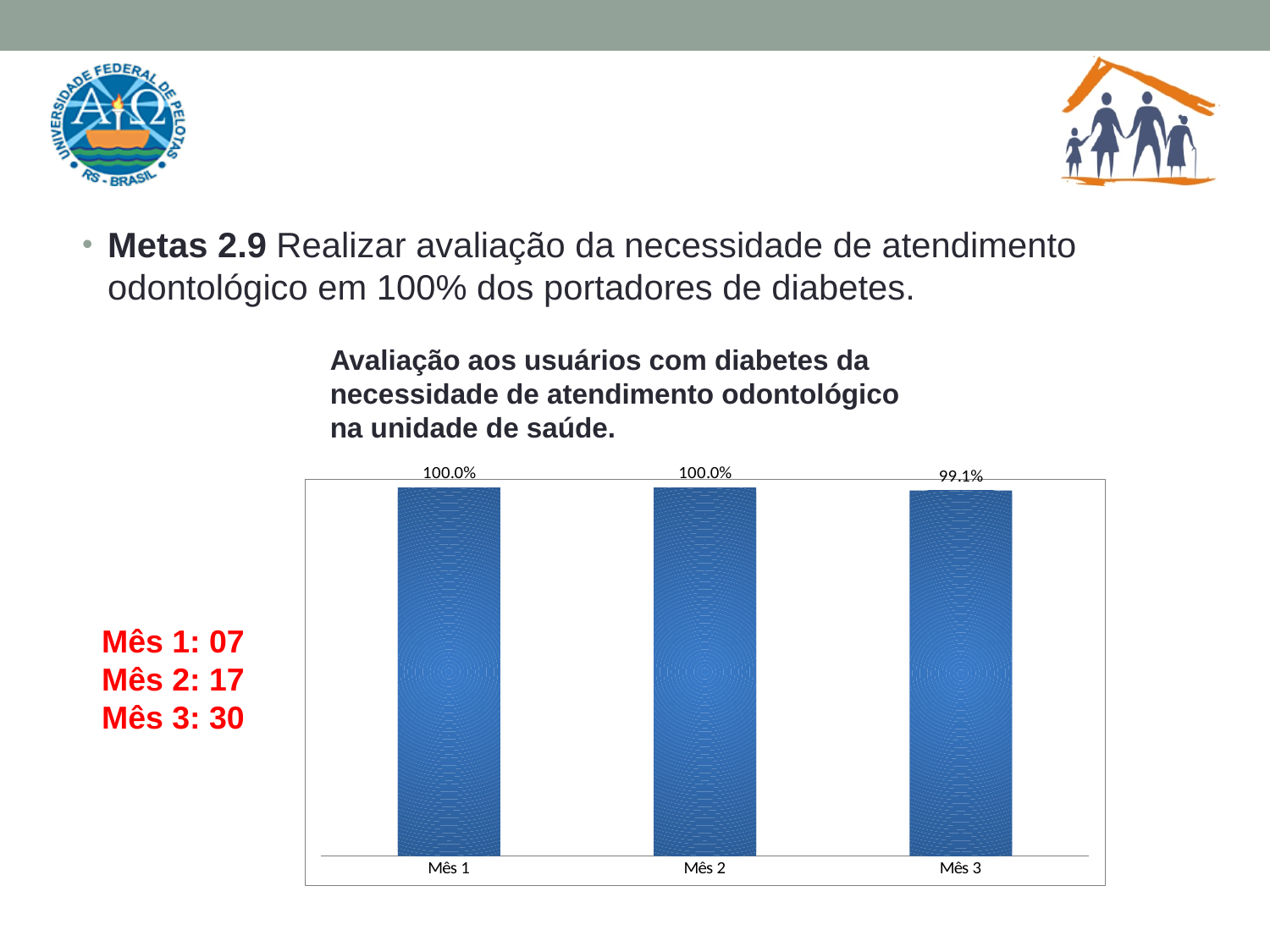
How many months are shown on the x axis? 3 What is the value for Mês 2? 100.0% What is the value for Mês 3? 99.1% What is the value for Mês 1? 100.0% What is the title of the chart? Avaliação aos usuários com diabetes da necessidade de atendimento odontológico na unidade de saúde. Which is larger, the value for Mês 2 or the value for Mês 3? Mês 2 Which month has the lowest value? Mês 3 Do the values rise or fall from Mês 2 to Mês 3? Fall Do Mês 1 and Mês 2 have the same value? Yes What is the difference between the values for Mês 1 and Mês 3? 0.9% What kind of chart is shown on the slide? Bar chart